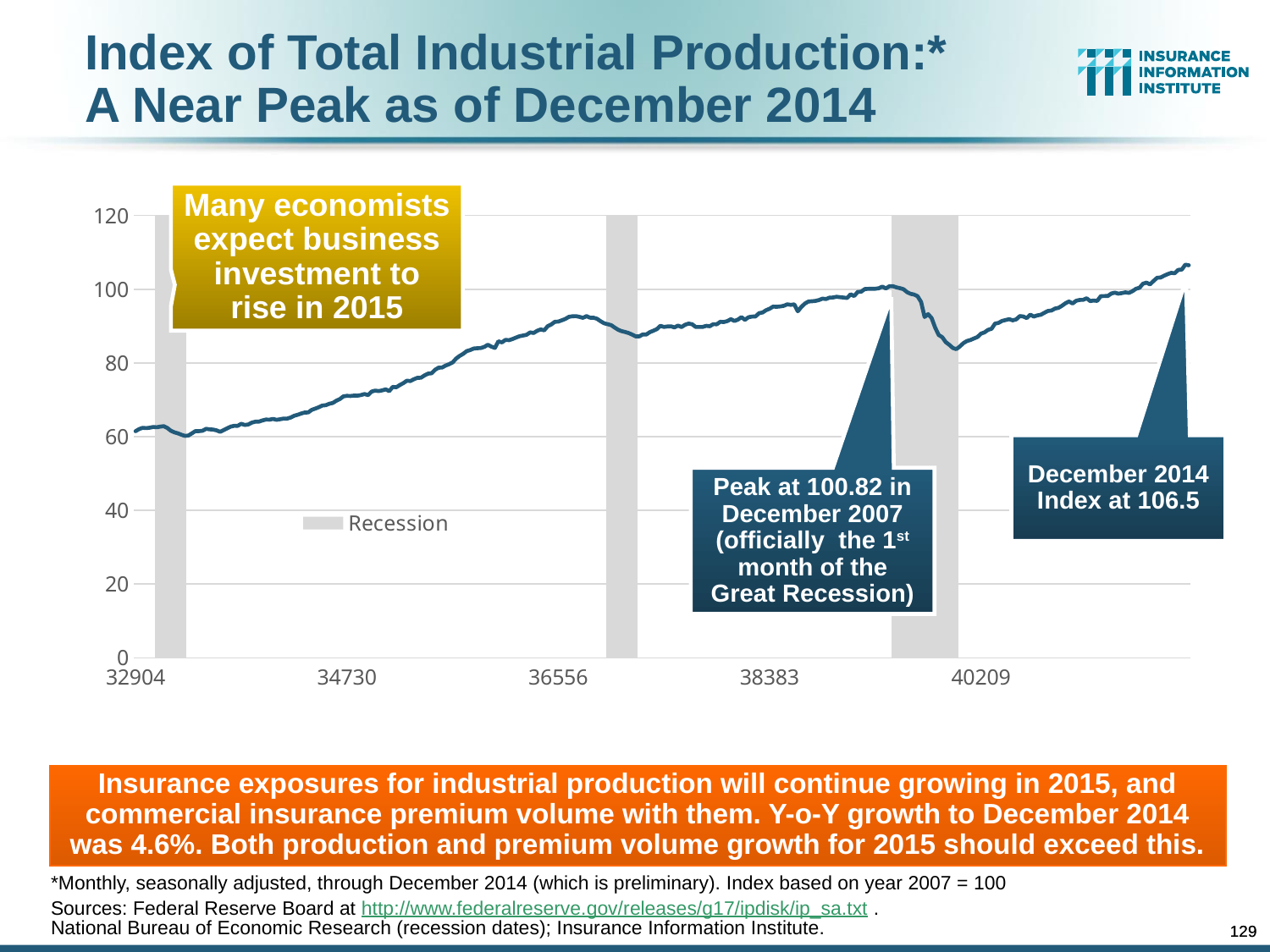
What does the grey shading on the chart represent, according to the legend? Recession Is the lowest index value after the December 2007 peak greater or less than 100? less What is the highest value on the vertical axis of the chart? 120 Is the index value at the start of the series (leftmost point) greater or less than 80? less How much higher is the December 2014 index value than the December 2007 peak? 5.68 How many shaded recession periods are shown on the chart? 3 Does the index generally rise or fall over the period shown? rise What was the Index of Total Industrial Production in December 2014? 106.5 Which is larger: the index in December 2014 or the peak in December 2007? December 2014 What value did the index peak at in December 2007? 100.82 What kind of chart is shown on the slide? line chart